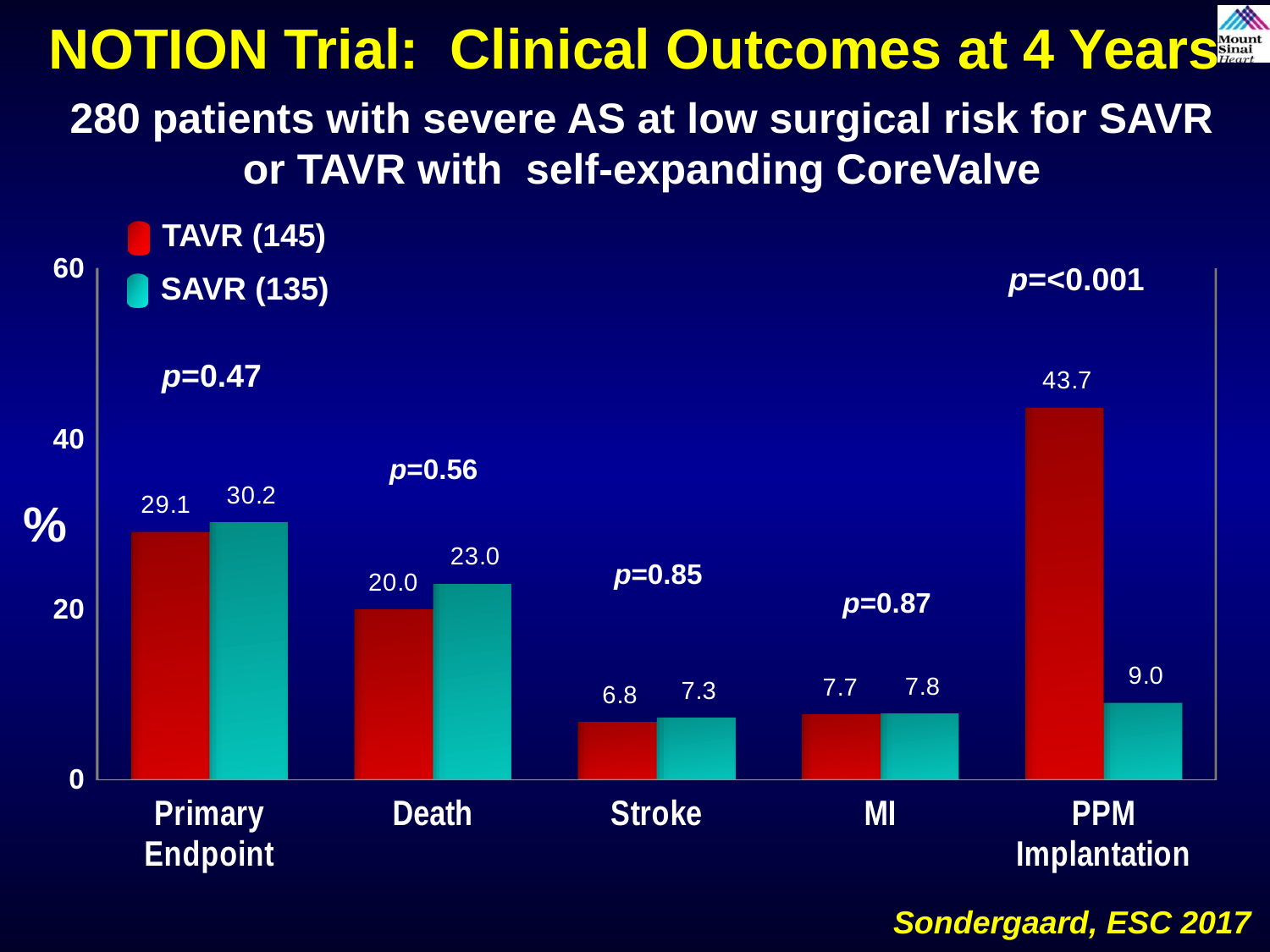
How many series does the legend list? 2 How many outcome categories are shown on the x axis? 5 What is the TAVR value for PPM Implantation? 43.7 What is the TAVR value for Stroke? 6.8 What is the difference between the TAVR and SAVR values for PPM Implantation? 34.7 What is the SAVR value for the Primary Endpoint? 30.2 What is the SAVR value for Death? 23.0 Which category has the highest TAVR value? PPM Implantation Which is larger for Death, the TAVR value or the SAVR value? SAVR Which category has the lowest SAVR value? Stroke What is the difference between the SAVR and TAVR values for Death? 3.0 What kind of chart is shown on the slide? Bar chart